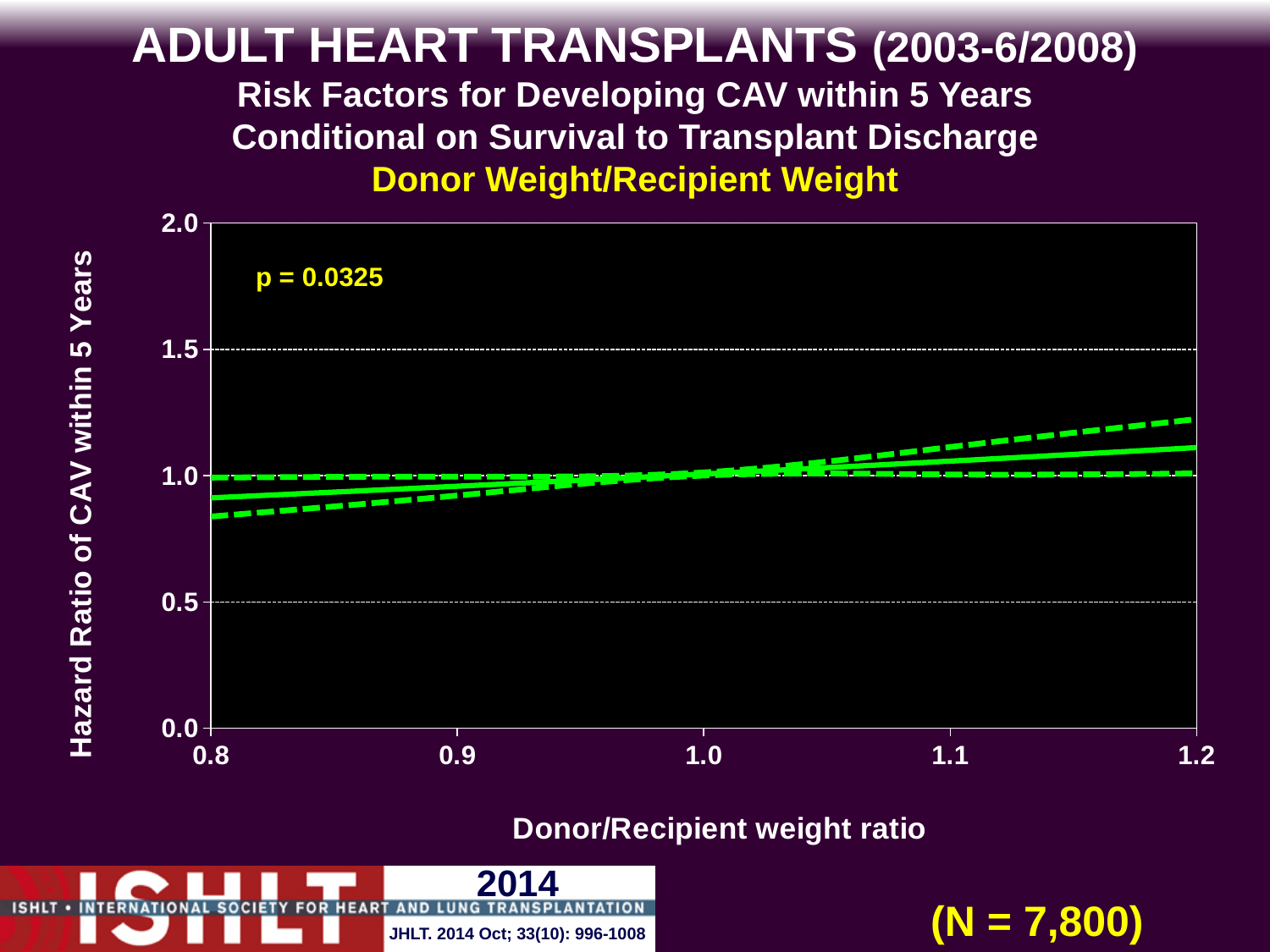
Does the solid hazard ratio line rise or fall as the donor/recipient weight ratio increases from 0.8 to 1.2? rises Is the upper dashed line at a donor/recipient weight ratio of 1.2 greater or less than 1.0? greater Is the upper dashed line at a donor/recipient weight ratio of 1.2 greater or less than 1.5? less What kind of chart is shown on the slide? line chart Is the lower dashed line at a donor/recipient weight ratio of 0.8 greater or less than 1.0? less How many tick labels are shown on the x axis? 5 What sample size (N) is shown on the slide? N = 7,800 Is the solid hazard ratio line higher at a weight ratio of 0.8 or at 1.2? 1.2 What p-value is printed on the chart? p = 0.0325 How many lines are plotted on the chart? 3